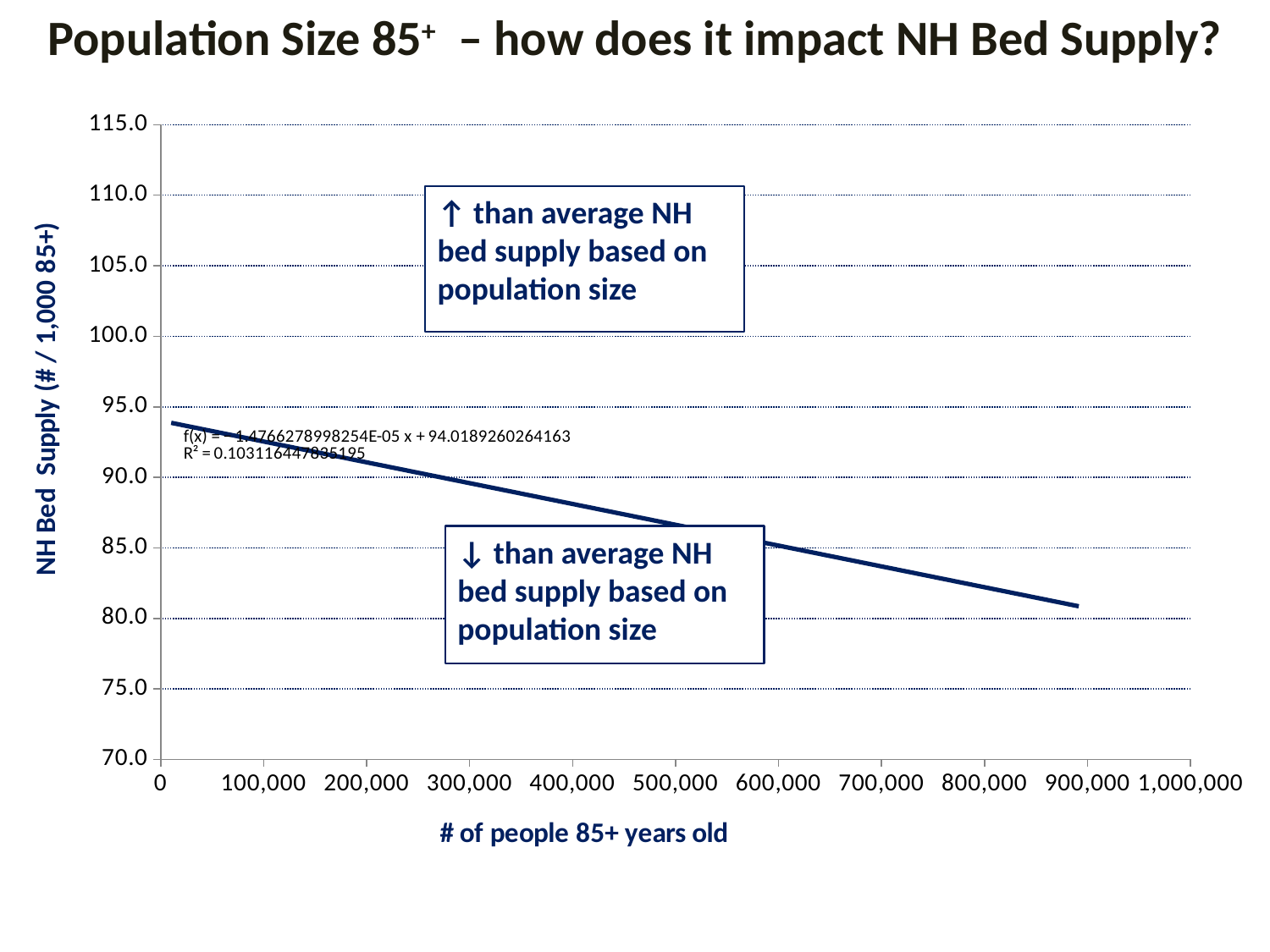
What is the title of the x axis? # of people 85+ years old Is the NH bed supply value at 900,000 people 85+ greater or less than 85.0? less What kind of chart is shown on the slide? line chart Is the NH bed supply value at 300,000 people 85+ greater or less than 85.0? greater What is the title of the y axis? NH Bed Supply (# / 1,000 85+) Is the NH bed supply value near 0 people 85+ greater or less than 90.0? greater What is the intercept shown in the trendline equation on the chart? 94.0189260264163 Does NH bed supply rise or fall as the number of people 85+ years old increases along the x axis? fall Which is larger, the NH bed supply at 100,000 people 85+ or at 800,000 people 85+? 100,000